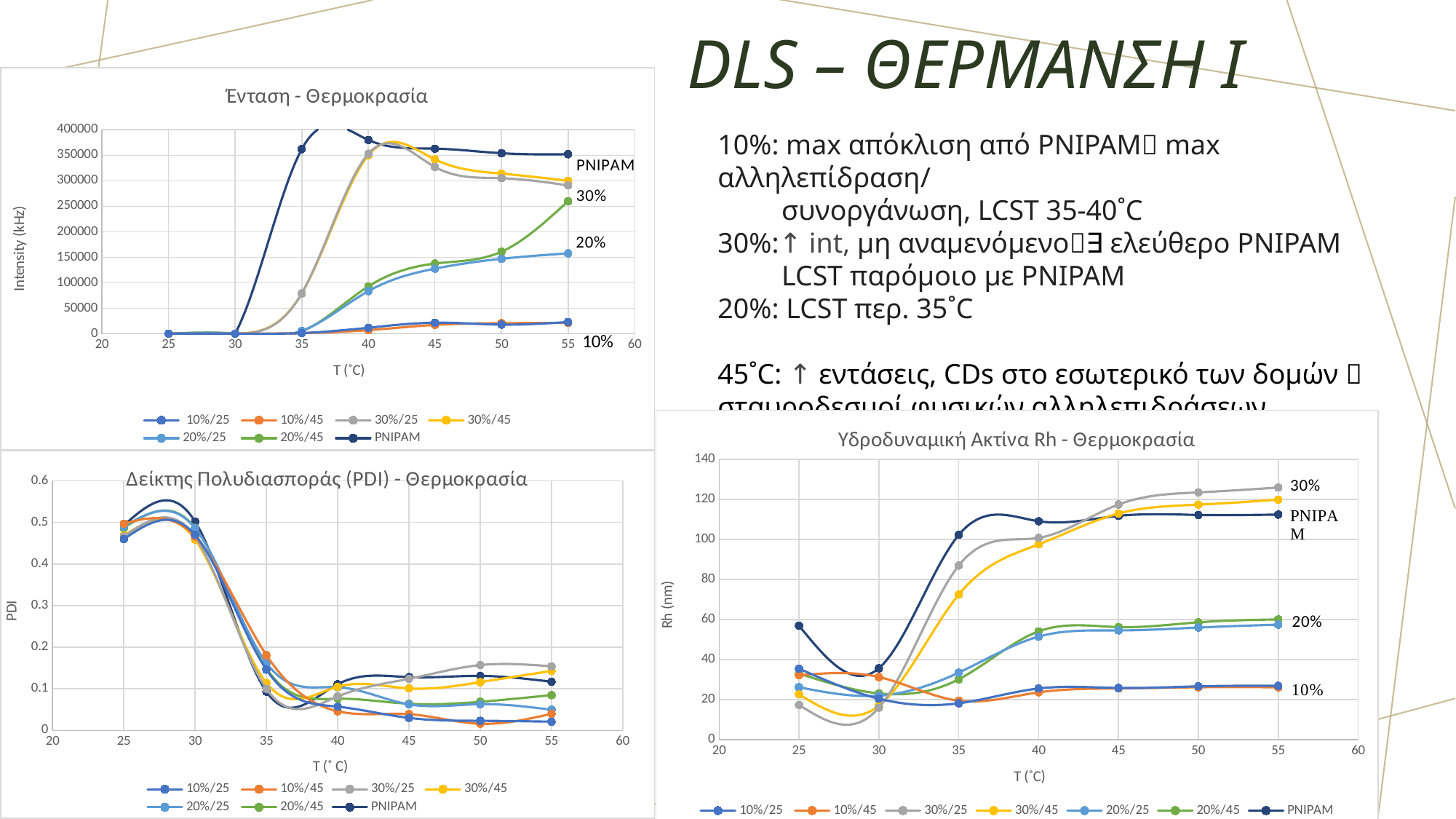
In the "Υδροδυναμική Ακτίνα Rh - Θερμοκρασία" chart, is the value for 10%/25 at 55 °C greater or less than 40? less In the "Ένταση - Θερμοκρασία" chart, is the value for PNIPAM at 35 °C greater or less than 300000? greater In the "Υδροδυναμική Ακτίνα Rh - Θερμοκρασία" chart, which series has the higher value at 55 °C, 30%/25 or 20%/45? 30%/25 In the "Υδροδυναμική Ακτίνα Rh - Θερμοκρασία" chart, does the value for 30%/45 rise or fall between 30 °C and 45 °C? rise What kind of chart is the "Ένταση - Θερμοκρασία" chart? Line chart What is the y-axis label of the "Υδροδυναμική Ακτίνα Rh - Θερμοκρασία" chart? Rh (nm) In the "Ένταση - Θερμοκρασία" chart, which series has the higher value at 55 °C, PNIPAM or 20%/45? PNIPAM What are the legend entries of the "Υδροδυναμική Ακτίνα Rh - Θερμοκρασία" chart? 10%/25, 10%/45, 30%/25, 30%/45, 20%/25, 20%/45, PNIPAM In the "Ένταση - Θερμοκρασία" chart, is the value for 20%/25 at 55 °C greater or less than 200000? less In the "Δείκτης Πολυδιασποράς (PDI) - Θερμοκρασία" chart, does the PDI for 30%/25 rise or fall between 30 °C and 35 °C? fall How many series does the legend of the "Ένταση - Θερμοκρασία" chart list? 7